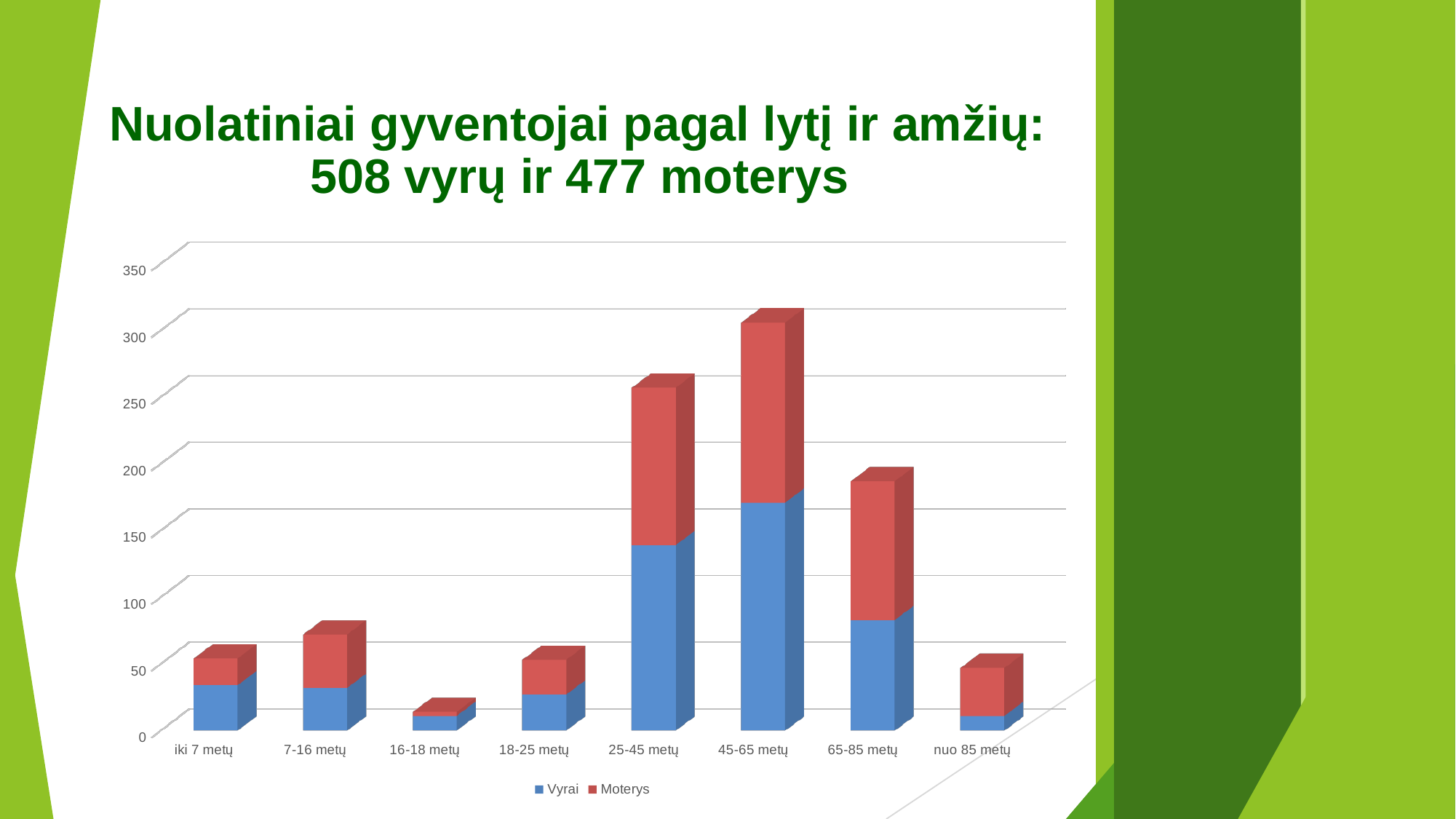
How many series does the legend list? 2 Which colour represents the Moterys series in the legend? red How many age categories are shown on the x axis? 8 Which age category has the tallest stacked bar? 45-65 metų Is the total value for 25-45 metų greater or less than 200? greater Which has the larger stacked bar, 25-45 metų or 65-85 metų? 25-45 metų Which age category has the shortest stacked bar? 16-18 metų Is the total value for 65-85 metų greater or less than 150? greater What kind of chart is shown on the slide? stacked bar chart Is the total value for 16-18 metų greater or less than 50? less Which has the larger stacked bar, iki 7 metų or 7-16 metų? 7-16 metų